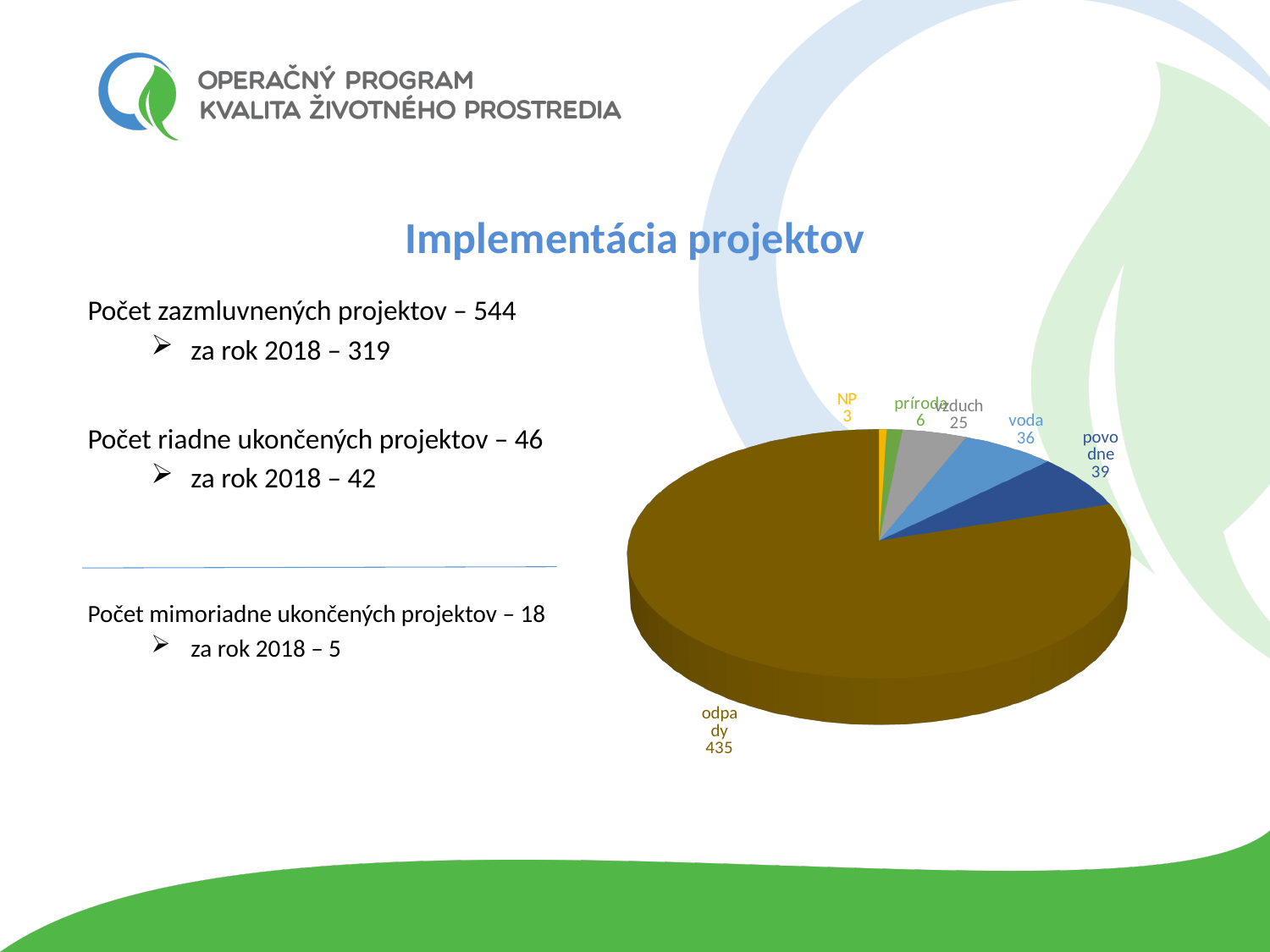
How many categories are shown in the pie chart? 6 What value is shown for 'vzduch' in the pie chart? 25 How many projects does the pie chart show for the 'odpady' category? 435 What is the total of all the values shown in the pie chart? 544 What value is shown for 'povodne' in the pie chart? 39 Which has the larger value in the pie chart, 'voda' or 'povodne'? povodne What is the difference between the values for 'odpady' and 'povodne' in the pie chart? 396 What type of chart is shown on the slide? pie chart What value is shown for 'NP' in the pie chart? 3 Which category has the largest slice in the pie chart? odpady What value is shown for 'voda' in the pie chart? 36 Which category has the smallest slice in the pie chart? NP